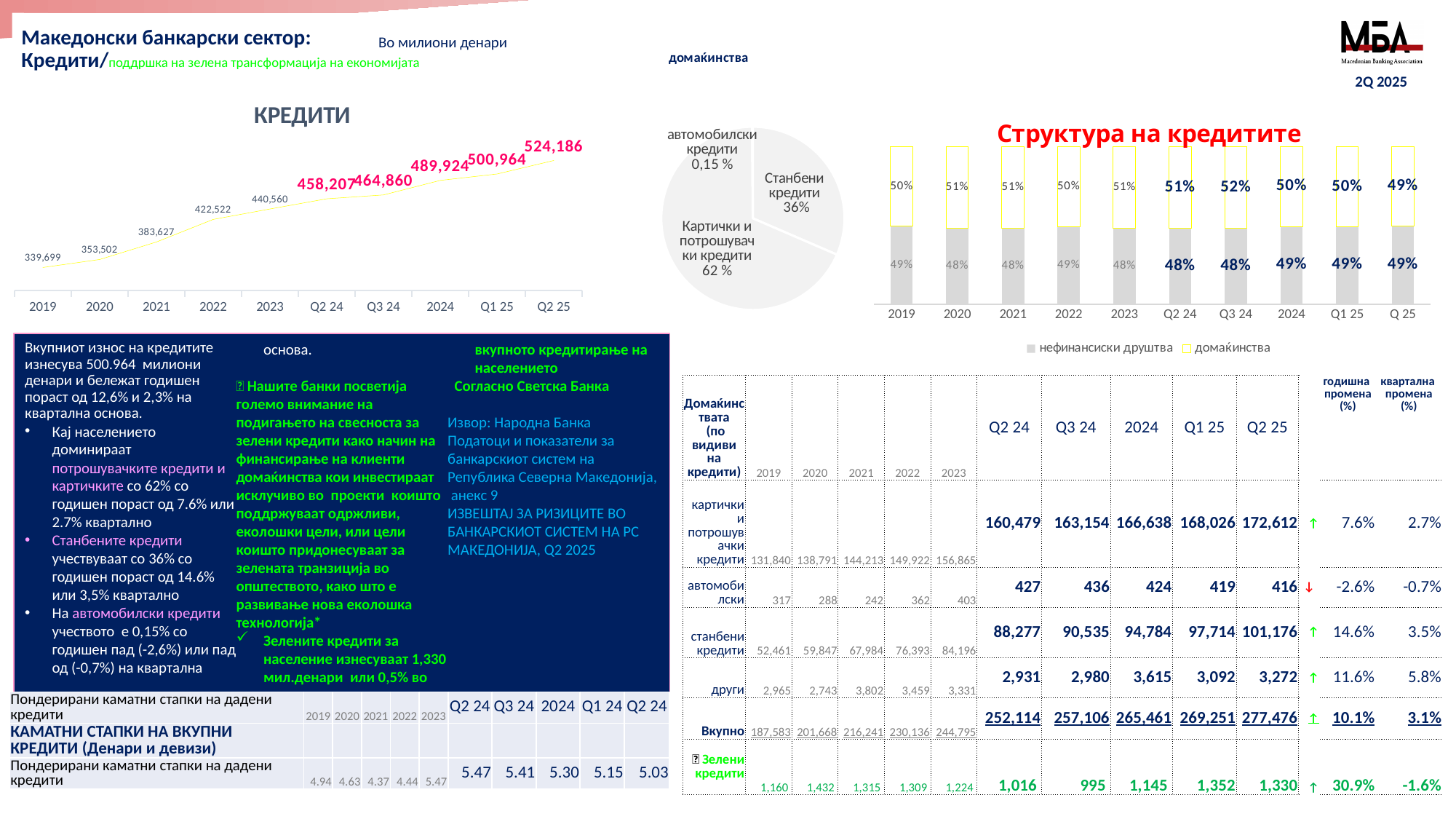
In the stacked bar chart titled Структура на кредитите, how many series does the legend list? 2 In the pie chart titled домаќинства, what share do Картички и потрошувачки кредити have? 62 % In the stacked bar chart titled Структура на кредитите, what is the value for домаќинства in Q3 24? 52% In the line chart titled КРЕДИТИ, how many data points are plotted? 10 In the line chart titled КРЕДИТИ, what is the value for 2019? 339,699 In the pie chart titled домаќинства, what share do Станбени кредити have? 36% In the line chart titled КРЕДИТИ, which category has the highest value? Q2 25 In the line chart titled КРЕДИТИ, what is the value for Q2 25? 524,186 In the pie chart titled домаќинства, which slice is the smallest? автомобилски кредити In the line chart titled КРЕДИТИ, what is the difference between the values for Q1 25 and 2024? 11,040 In the line chart titled КРЕДИТИ, which category has the lowest value? 2019 In the line chart titled КРЕДИТИ, do the values rise or fall from 2019 to Q2 25? rise